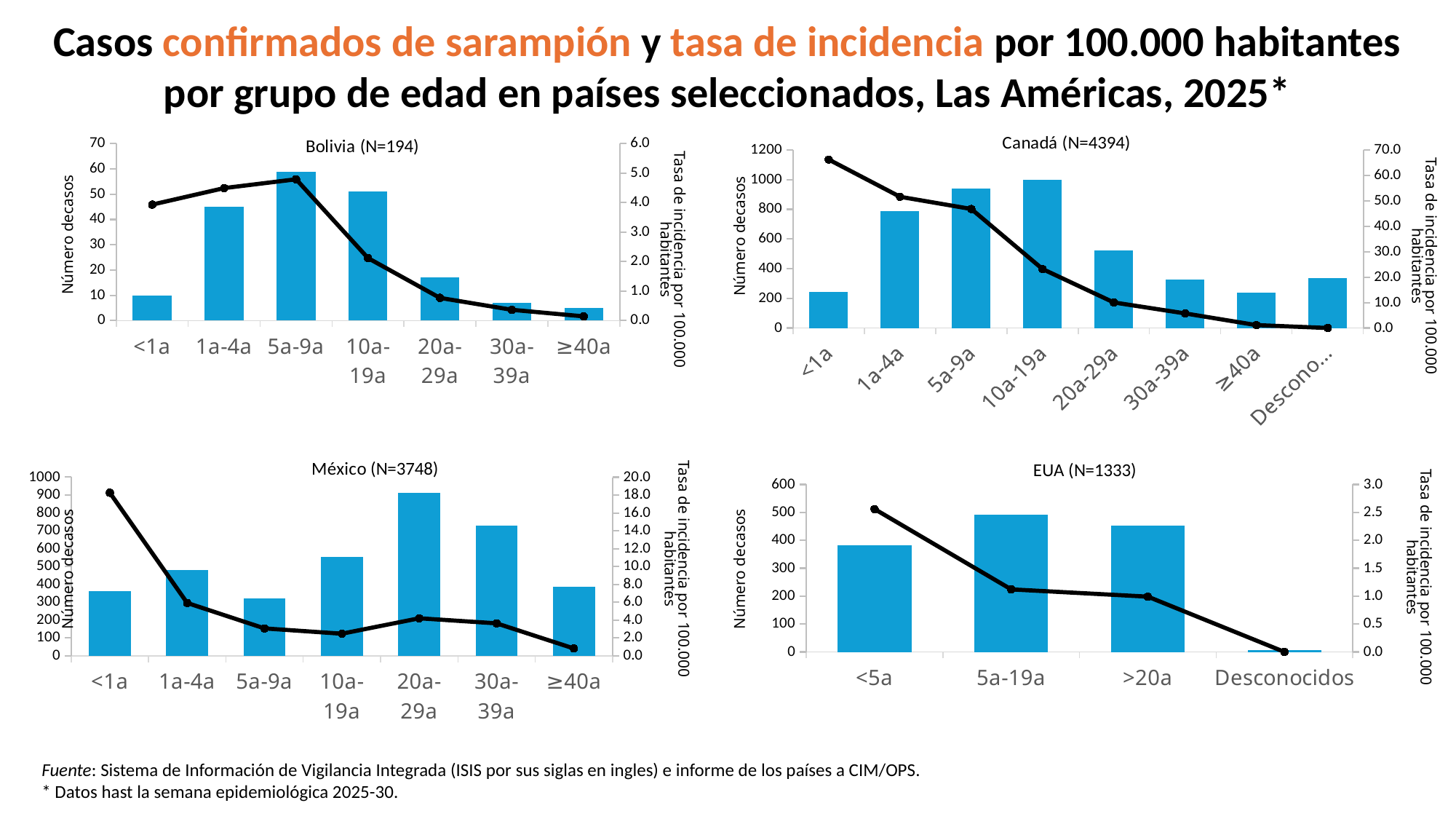
On the EUA (N=1333) chart, does the incidence-rate line rise or fall from <5a to Desconocidos? fall On the Canadá (N=4394) chart, how many categories are shown on the x axis? 8 On the México (N=3748) chart, which age group has the tallest bar? 20a-29a What kind of chart is the EUA (N=1333) chart? bar chart with a line overlay On the México (N=3748) chart, is the bar for 30a-39a greater or less than 600? greater On the Bolivia (N=194) chart, which age group has the tallest bar? 5a-9a On the Canadá (N=4394) chart, at which age group is the incidence-rate line highest? <1a On the Bolivia (N=194) chart, how many age-group categories are shown on the x axis? 7 On the Bolivia (N=194) chart, is the bar for 1a-4a greater or less than 40? greater On the Canadá (N=4394) chart, is the bar for 20a-29a greater or less than 600? less On the EUA (N=1333) chart, which category has the shortest bar? Desconocidos